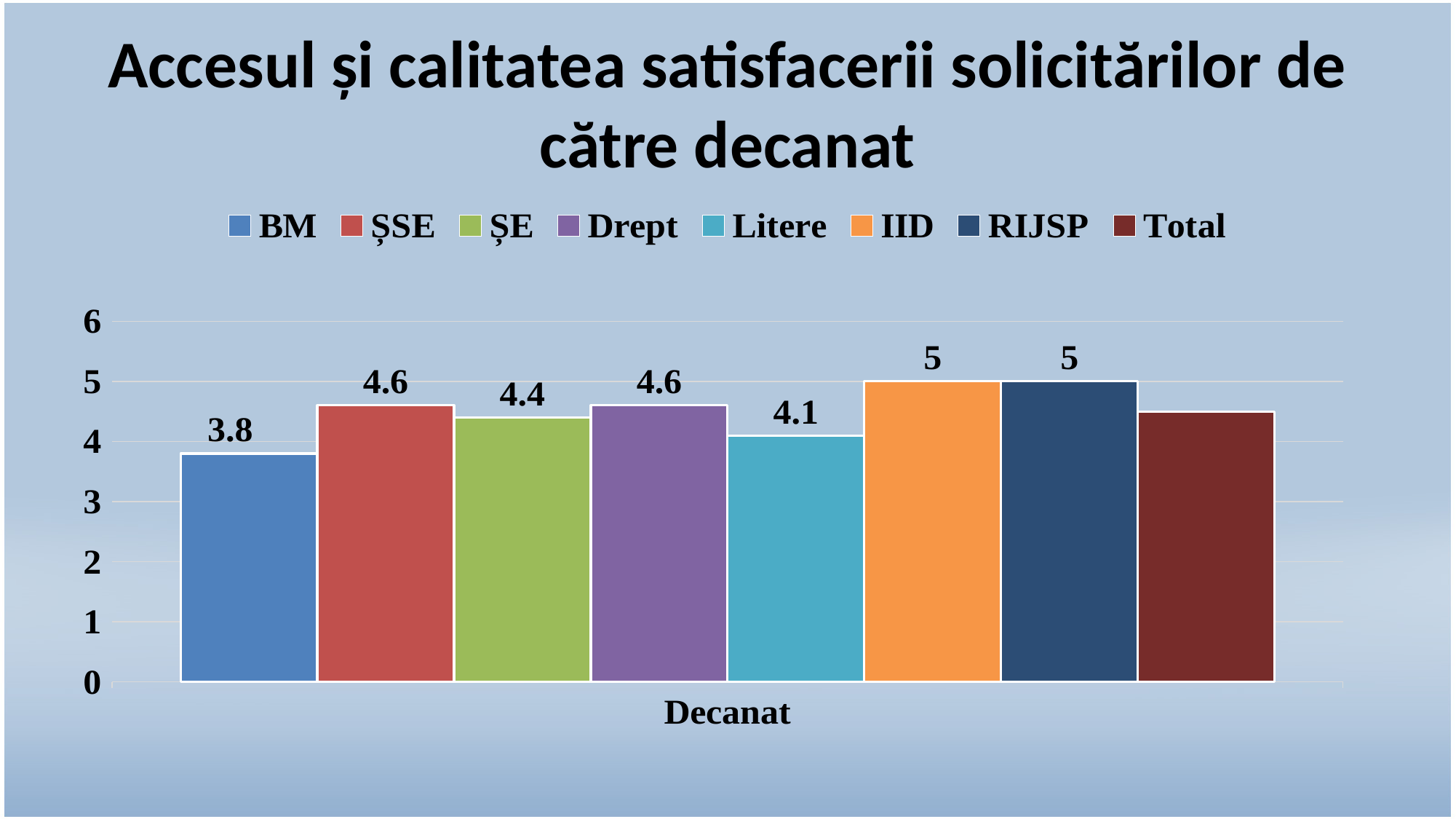
What is the category label shown on the x axis? Decanat Which series has the lowest value? BM What is the value for IID? 5 What is the value for BM? 3.8 Is the value for Total greater or less than 4? greater What is the value for Litere? 4.1 What is the difference between the values for ȘSE and BM? 0.8 Which is larger, the value for Drept or the value for Litere? Drept What is the difference between the values for IID and Litere? 0.9 How many series does the legend list? 8 What kind of chart is shown on the slide? bar chart What is the value for ȘE? 4.4